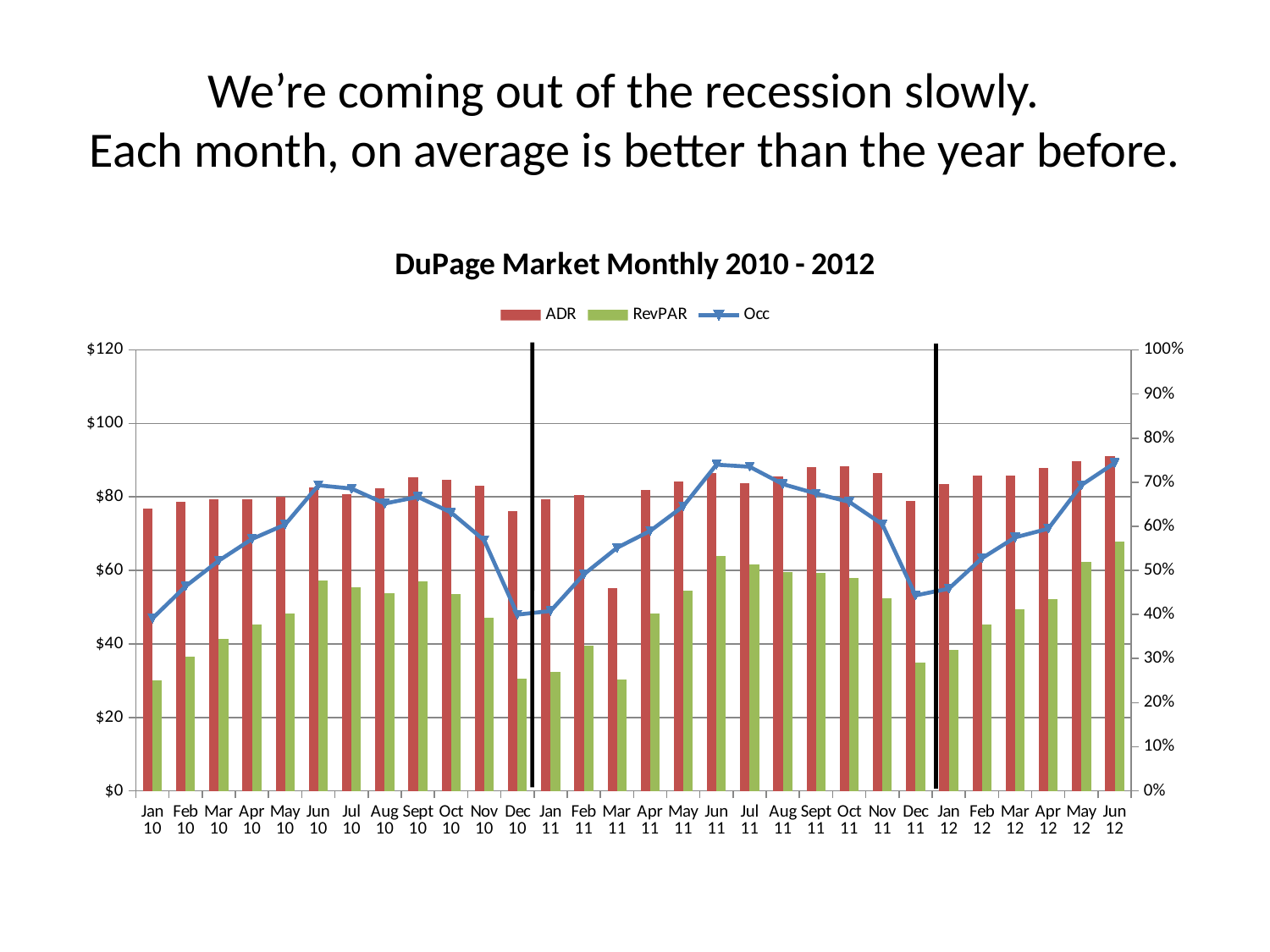
Which series is plotted as a line rather than bars? Occ Is the ADR for Jan 10 greater or less than $60? greater What is the title of the chart? DuPage Market Monthly 2010 - 2012 Is the RevPAR for Jan 10 greater or less than $40? less Which month has the lowest ADR? Mar 11 Which is larger, the RevPAR for Jun 10 or for Jun 11? Jun 11 How many series does the legend list? 3 How many months are shown on the x axis? 30 Is the Occ for Dec 11 greater or less than 60%? less What kind of chart is this? Combination bar and line chart Does Occ rise or fall from Jan 10 to Jun 10? rise Which month has the highest RevPAR? Jun 12